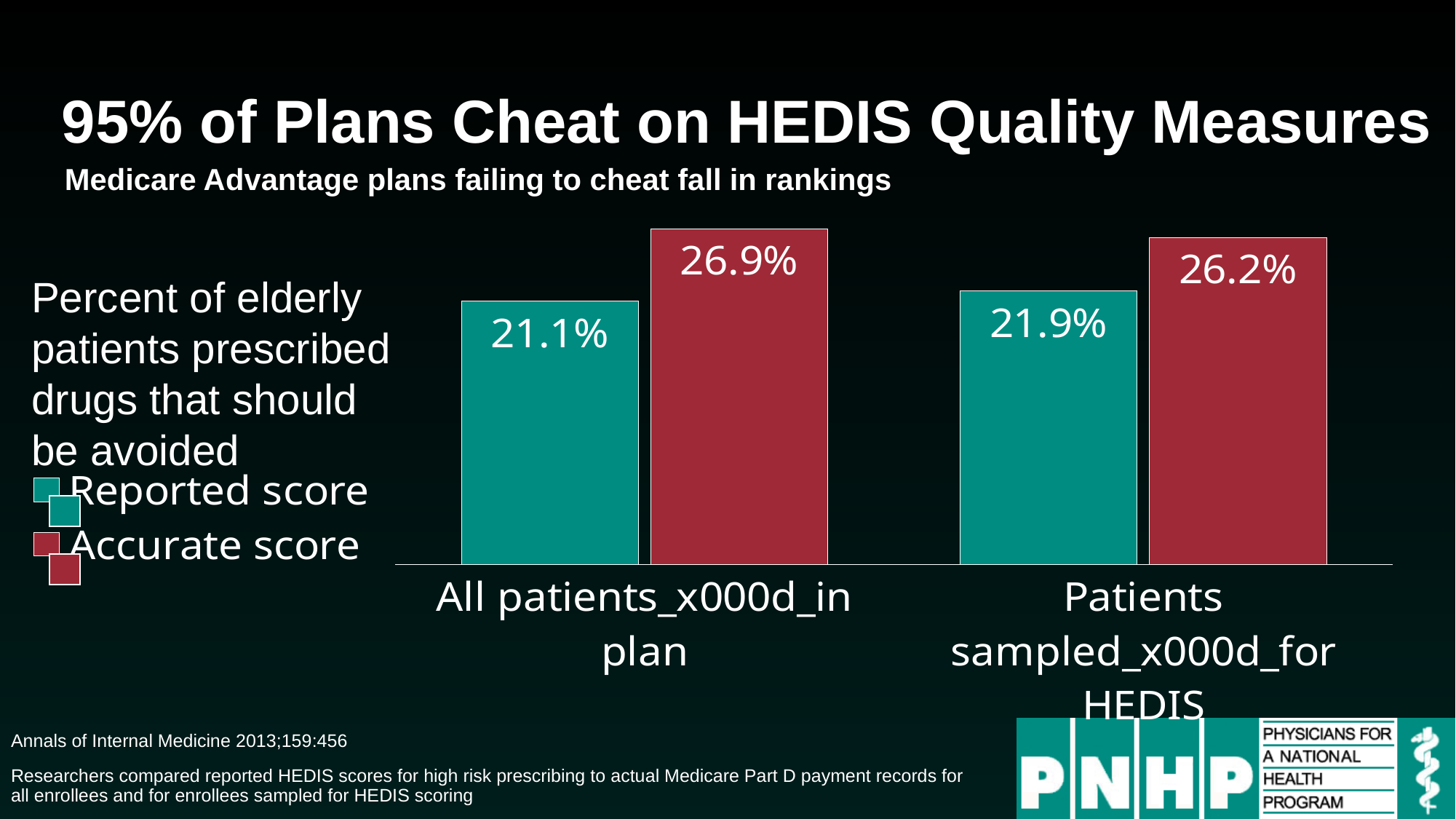
Which is larger for Patients sampled for HEDIS, the Reported score or the Accurate score? Accurate score What is the Reported score for All patients in plan? 21.1% How many series does the chart's legend list? 2 What is the Reported score for Patients sampled for HEDIS? 21.9% Which bar in the chart has the highest value? Accurate score for All patients in plan What is the difference between the Accurate score and the Reported score for Patients sampled for HEDIS? 4.3% Which bar in the chart has the lowest value? Reported score for All patients in plan What is the Accurate score for Patients sampled for HEDIS? 26.2% What is the difference between the Accurate score and the Reported score for All patients in plan? 5.8% What kind of chart is shown on the slide? Bar chart How many categories are shown on the x axis of the chart? 2 What is the Accurate score for All patients in plan? 26.9%